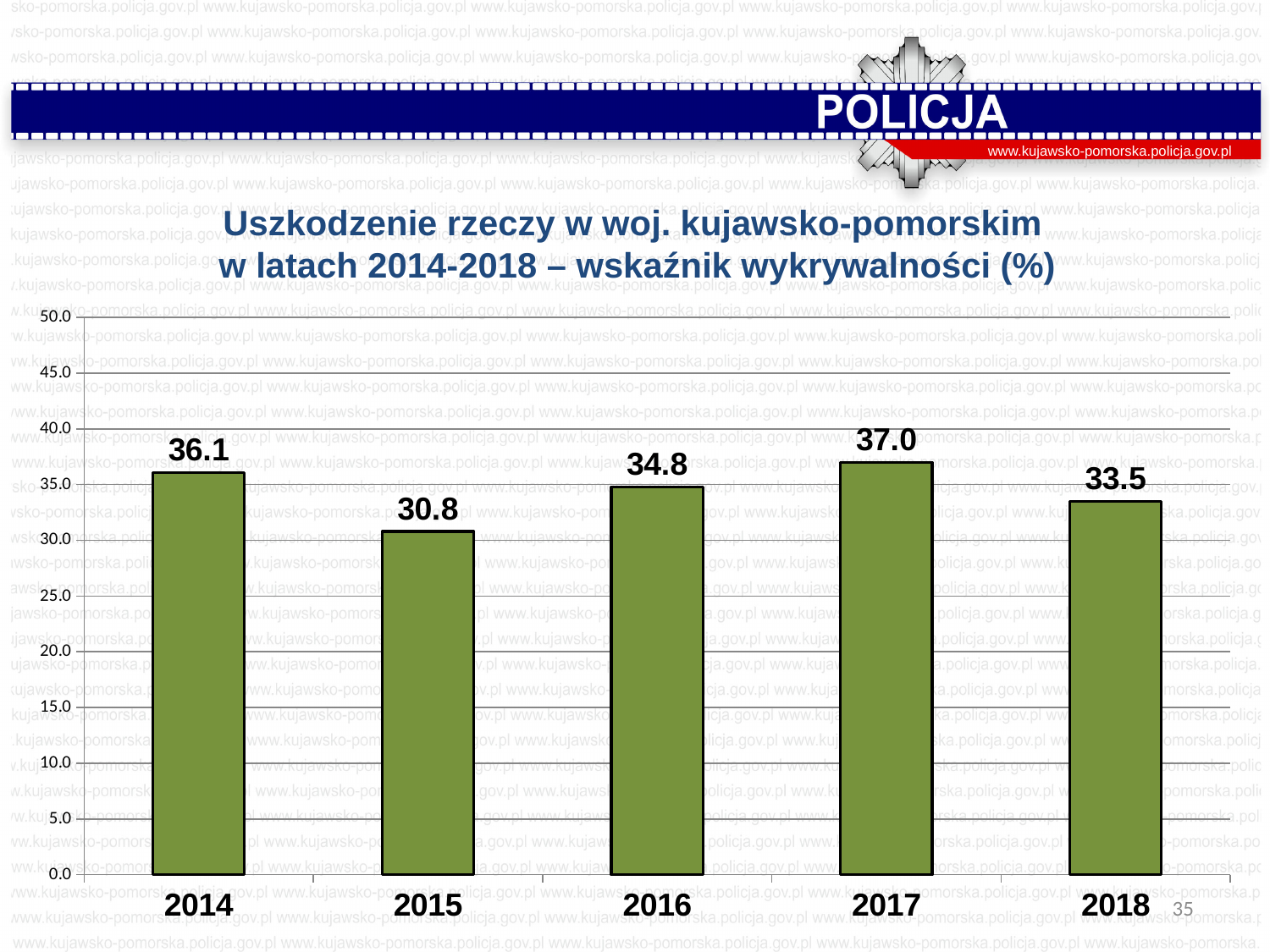
What is the value shown for 2017? 37.0 What is the difference between the values for 2017 and 2015? 6.2 Which year has the highest value? 2017 Does the value rise or fall from 2015 to 2016? rise What is the difference between the values for 2014 and 2018? 2.6 What is the detection rate value shown for 2014? 36.1 How many years are shown on the x axis? 5 What kind of chart is this? bar chart What is the value shown for 2015? 30.8 Which year has the lowest value? 2015 Is the value for 2018 greater or less than 30.0? greater Which is larger, the value for 2016 or the value for 2018? 2016